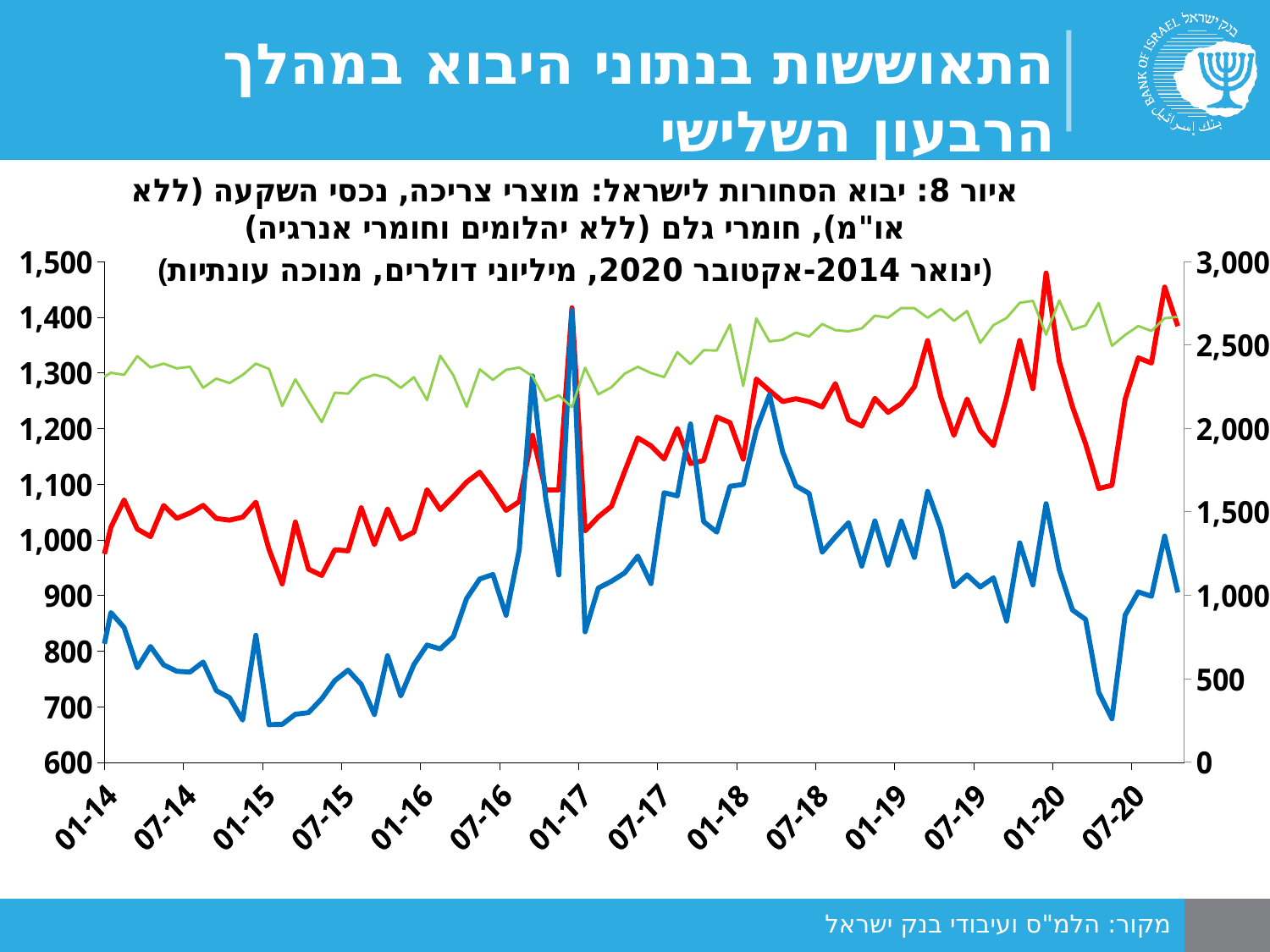
What is the highest value shown on the right y axis of the chart? 3,000 Which line is plotted highest on the chart across the whole period: the green, red or blue line? green How many lines are plotted on the chart? 3 Does the blue line rise or fall between 01-15 and 01-18? rise What is the highest value shown on the left y axis of the chart? 1,500 Does the red line rise or fall between 01-15 and 07-17? rise Does the blue line rise or fall between 01-14 and 01-15? fall What kind of chart is shown on the slide? line chart How many tick labels are shown on the x axis of the chart? 14